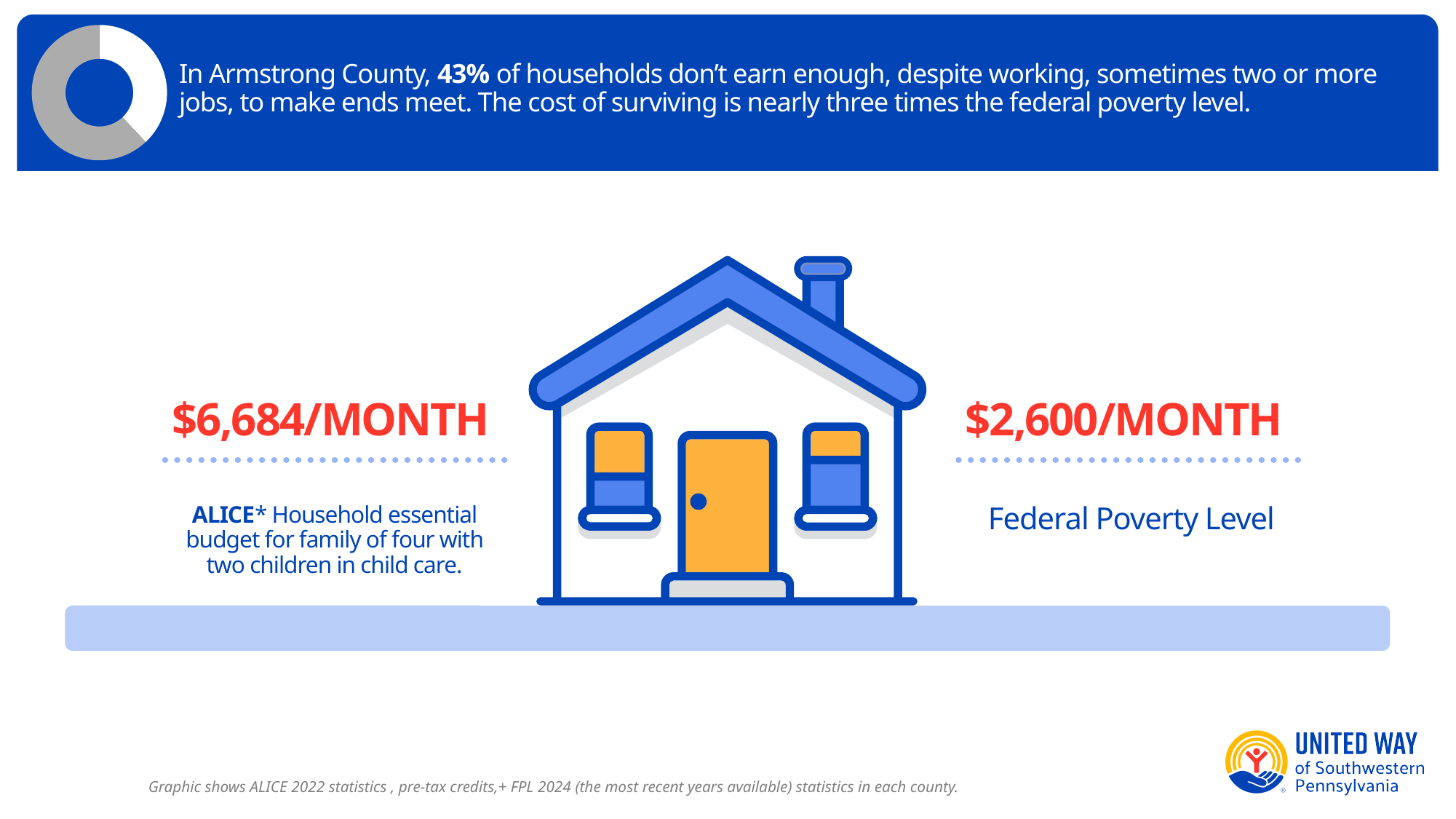
What family composition does the ALICE household essential budget describe? Family of four with two children in child care What is the difference between the ALICE household essential budget and the Federal Poverty Level per month? $4,084/month What is the ALICE household essential budget per month shown on the slide? $6,684/MONTH In the donut chart, which slice is larger, the blue one or the grey one? The grey one What is the Federal Poverty Level per month shown on the slide? $2,600/MONTH What kind of chart is shown in the top-left corner of the slide? Donut (pie) chart Which county does the slide's statistic refer to? Armstrong County Is the share shown by the blue slice of the donut chart greater or less than 50%? less How many slices does the donut chart have? 2 Which is larger, the ALICE household essential budget or the Federal Poverty Level? ALICE household essential budget